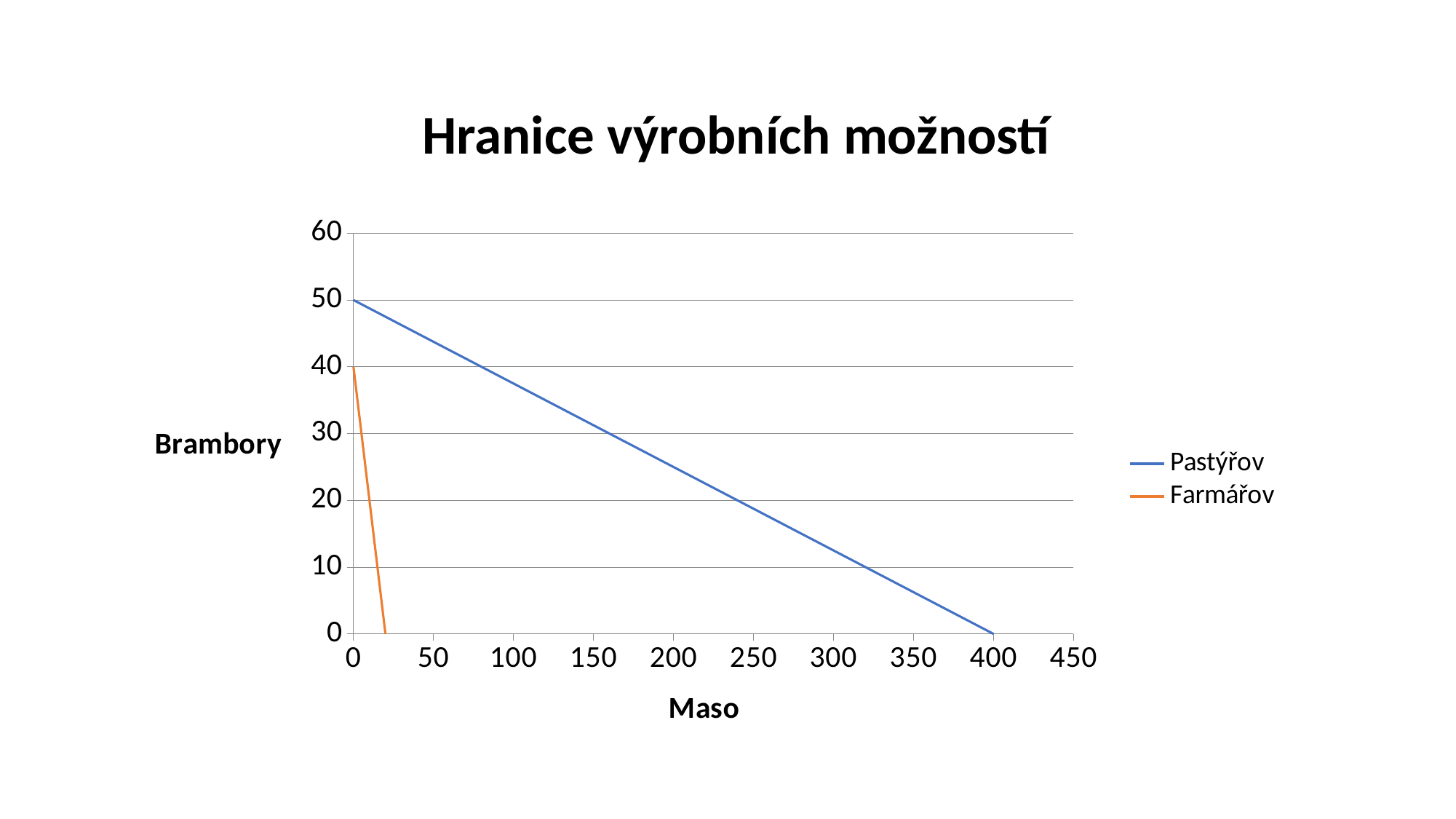
What is the difference between the Brambory values of Pastýřov and Farmářov when Maso is 0? 10 How many series does the legend list? 2 Which series has the higher Brambory value when Maso is 0, Pastýřov or Farmářov? Pastýřov What is the Brambory value for Pastýřov when Maso is 0? 50 What kind of chart is shown on the slide? line chart Is the Brambory value for Pastýřov at Maso 200 greater or less than 30? less What is the Maso value for Pastýřov when Brambory is 0? 400 What are the two series named in the legend? Pastýřov and Farmářov What is the Brambory value for Farmářov when Maso is 0? 40 What is the title of the chart? Hranice výrobních možností Is the Maso value where the Farmářov line reaches Brambory 0 greater or less than 50? less Does the Pastýřov line rise or fall as Maso increases? fall